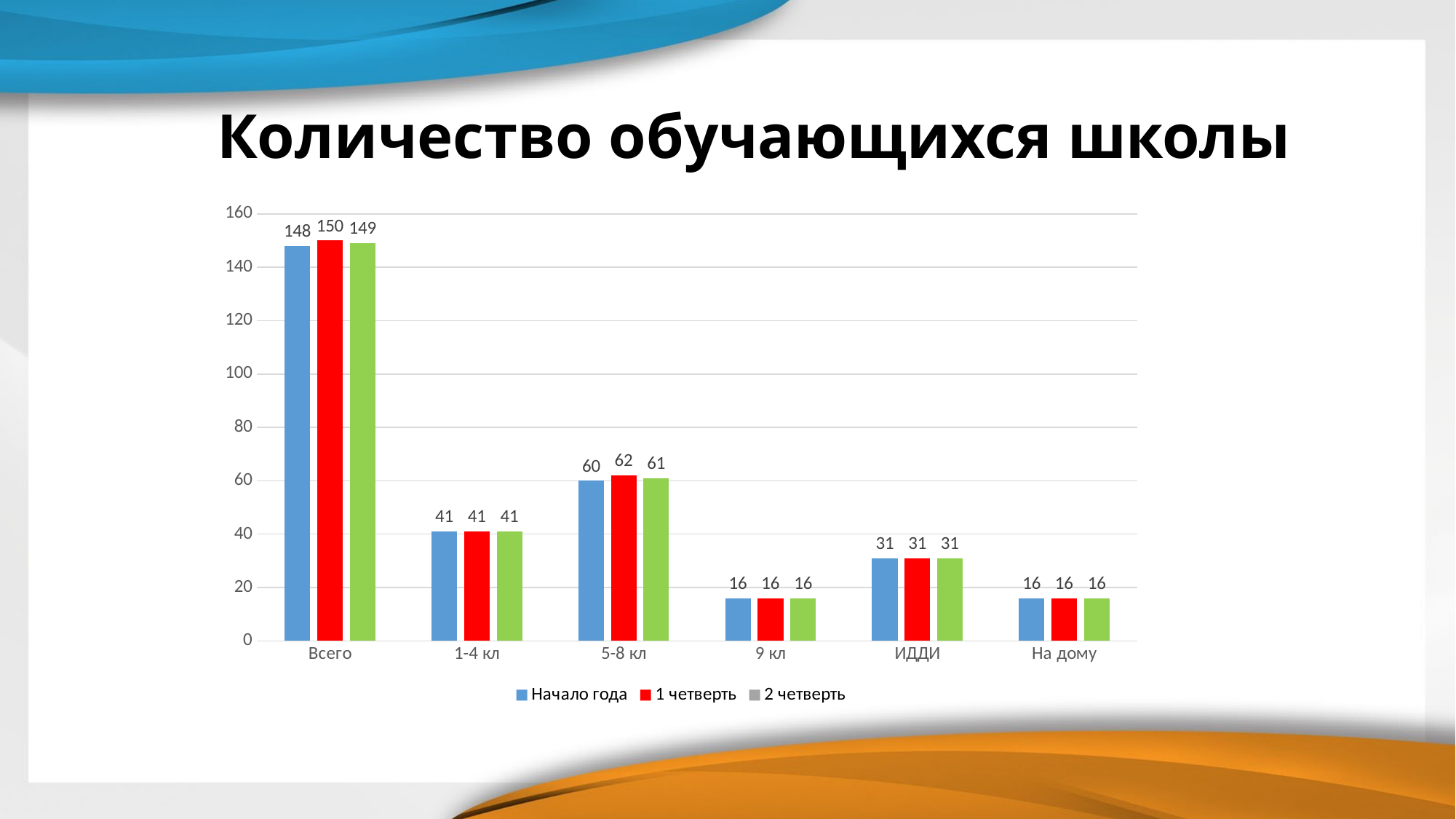
Which is larger for 5-8 кл: the Начало года value or the 2 четверть value? 2 четверть What is the difference between the 1 четверть and Начало года values for Всего? 2 What is the value for Всего in the Начало года series? 148 Which category has the lowest value in the Начало года series? 9 кл and На дому (both 16) Is the value for 1-4 кл in the Начало года series greater or less than 60? less What is the value for ИДДИ in the 2 четверть series? 31 What is the value for 5-8 кл in the 1 четверть series? 62 What is the title of the slide? Количество обучающихся школы What kind of chart is shown on the slide? bar chart How many series does the legend list? 3 Which category has the highest value in the 1 четверть series? Всего How many categories are shown on the x axis? 6